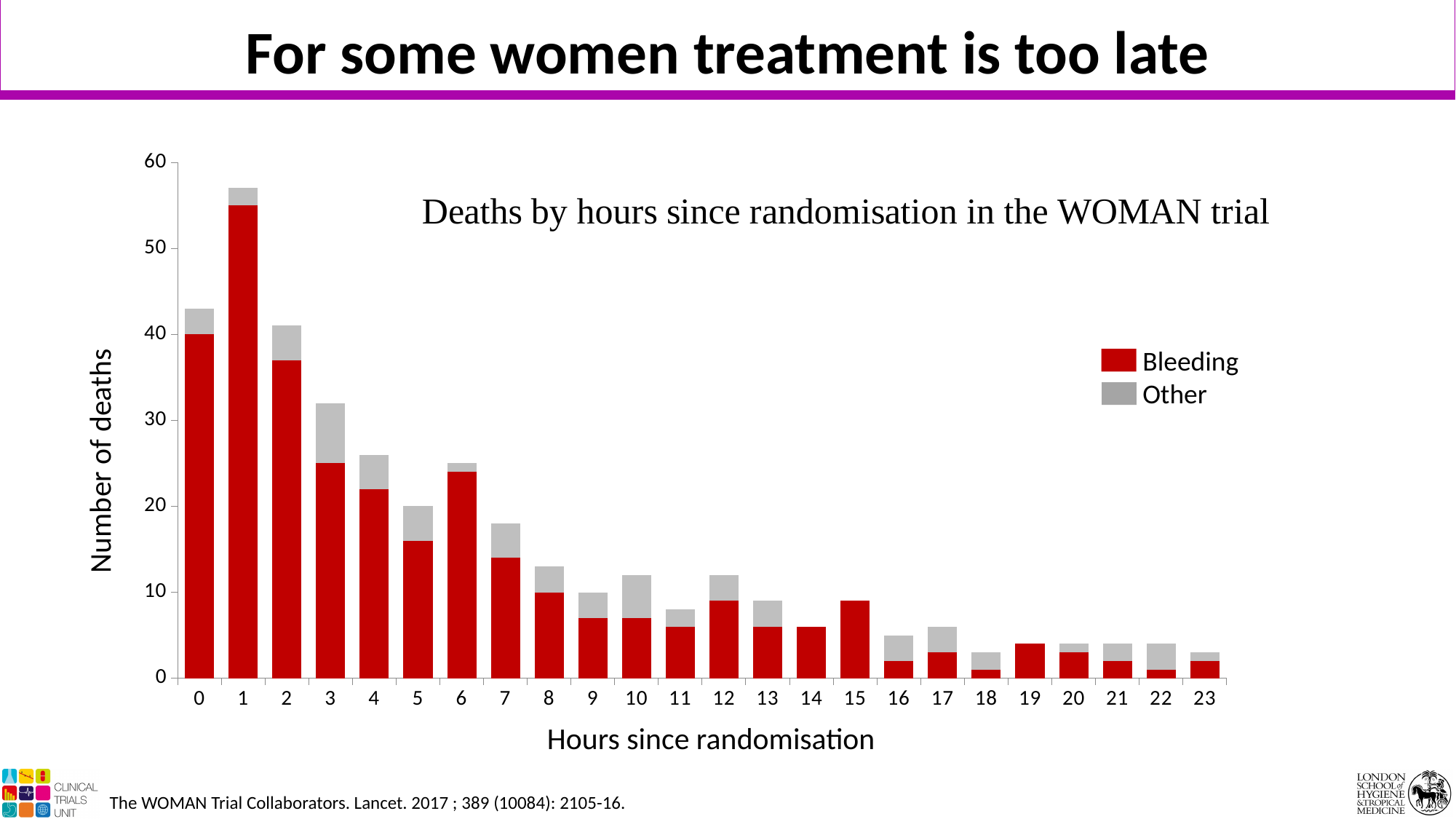
Is the number of Bleeding deaths at hour 15 greater or less than 10? less What kind of chart is shown on the slide? Stacked bar chart Do the total deaths generally rise or fall from hour 1 to hour 23? Fall Is the total number of deaths at hour 1 greater or less than 50? greater What is the number of Bleeding deaths at hour 0? 40 What is the number of Bleeding deaths at hour 8? 10 Which has more Bleeding deaths, hour 11 or hour 12? Hour 12 How many hour categories are shown on the x axis? 24 Is the total number of deaths at hour 3 greater or less than 30? greater Which colour represents Other deaths in the legend? Grey At which hour since randomisation is the total number of deaths highest? 1 How many series does the legend list? 2